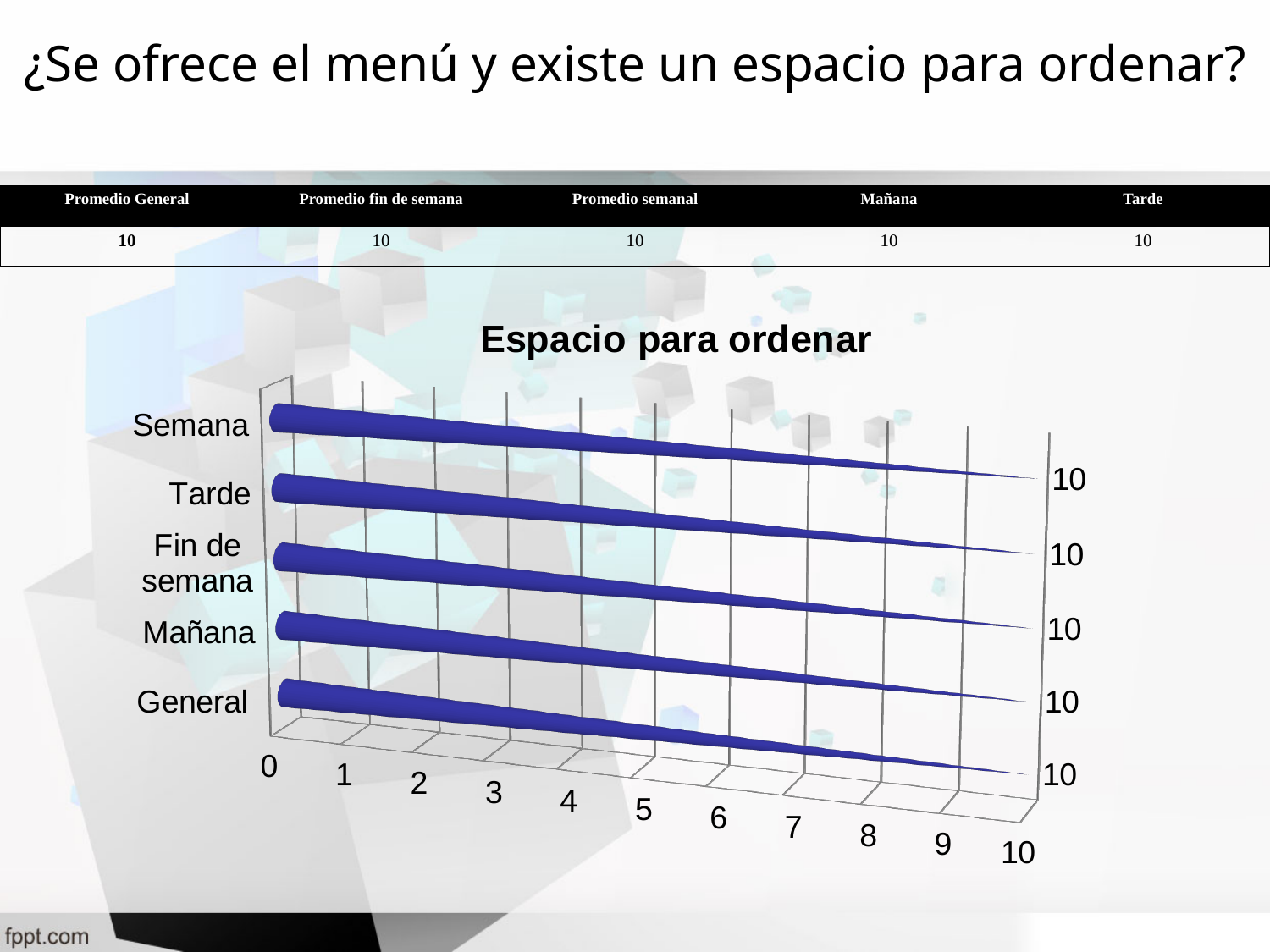
What is the difference between the values for Semana and General in the Espacio para ordenar chart? 0 What is the value for Tarde in the Espacio para ordenar chart? 10 What kind of chart is the Espacio para ordenar chart? bar chart What is the value for Fin de semana in the Espacio para ordenar chart? 10 Is the value for Mañana in the Espacio para ordenar chart greater or less than 5? greater What is the value for Mañana in the Espacio para ordenar chart? 10 What is the value for Semana in the Espacio para ordenar chart? 10 How many categories are plotted in the Espacio para ordenar chart? 5 What is the title of the chart on the slide? Espacio para ordenar What is the value for General in the Espacio para ordenar chart? 10 In the Espacio para ordenar chart, is the value for Tarde larger than, smaller than, or equal to the value for Fin de semana? equal What is the highest value shown on the horizontal axis of the Espacio para ordenar chart? 10